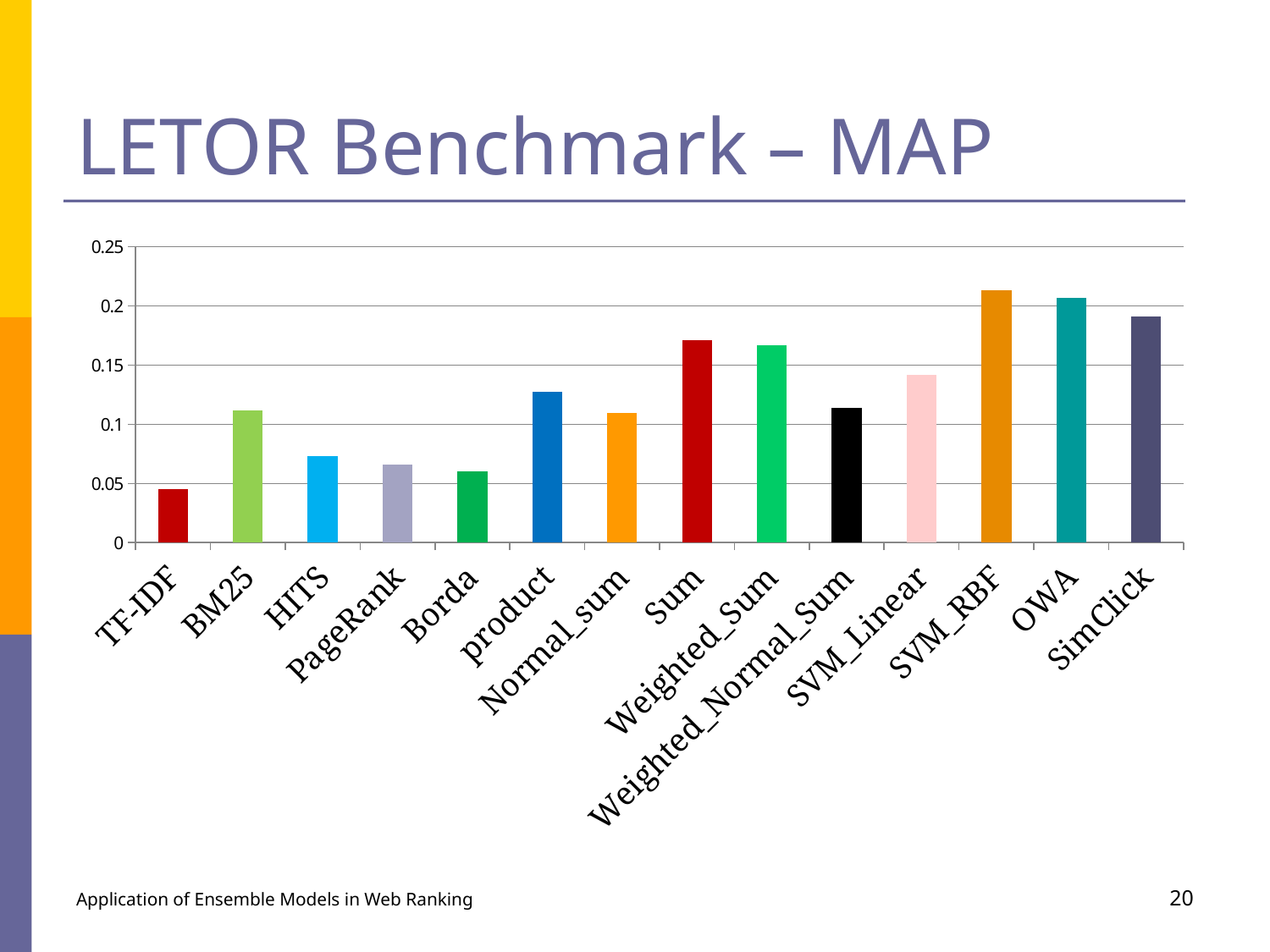
Which category has the highest value on the chart? SVM_RBF Is the value for SimClick greater or less than 0.2? less How many categories (ranking methods) are plotted on the chart? 14 Is the value for product greater or less than 0.1? greater Is the value for Sum greater or less than 0.15? greater What kind of chart is shown on the slide? bar chart Which is larger, the value for Sum or the value for Borda? Sum Which is larger, the value for HITS or the value for product? product Which category has the lowest value on the chart? TF-IDF What is the title of the slide containing the chart? LETOR Benchmark – MAP